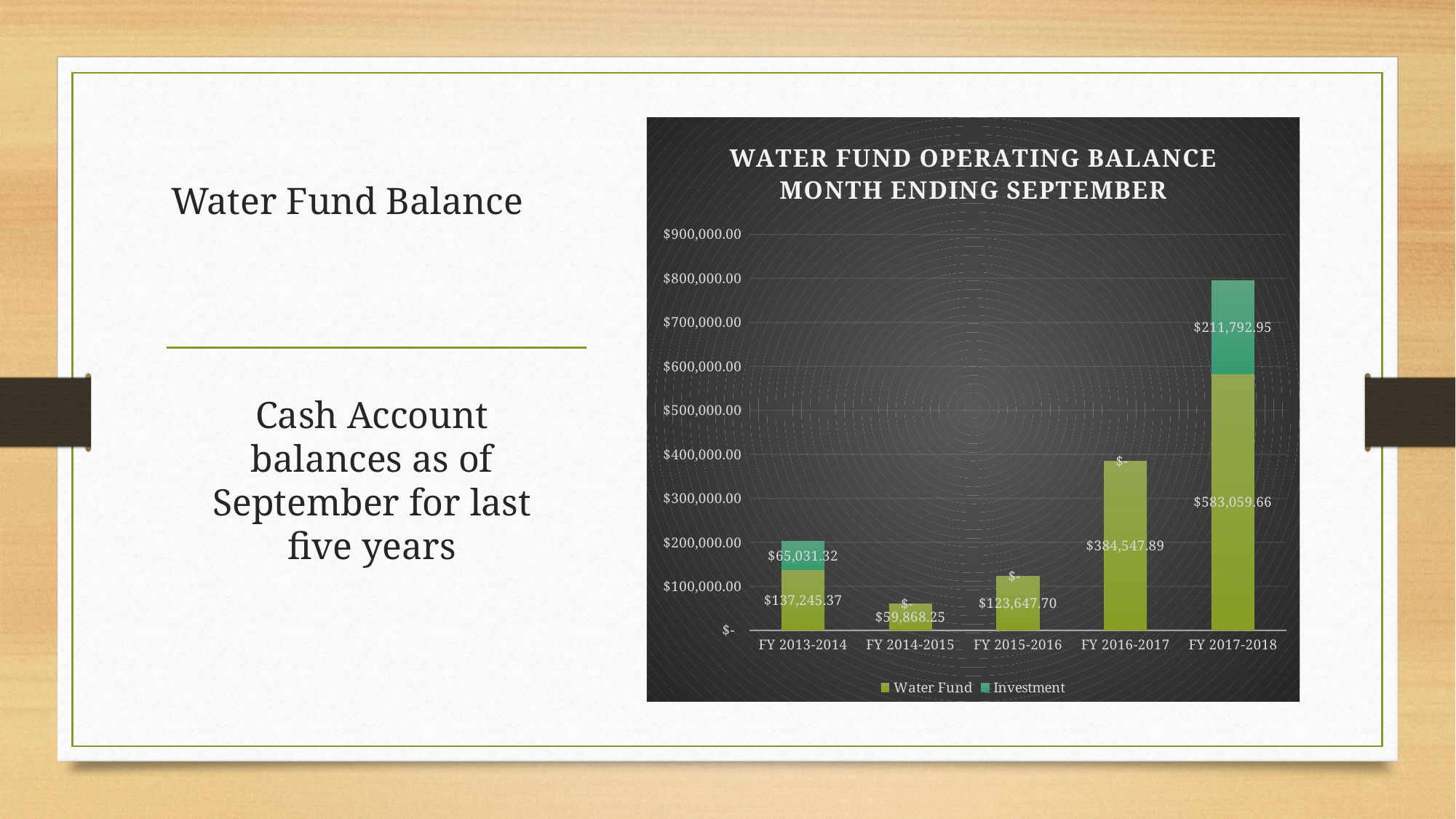
How many fiscal years are shown on the x axis? 5 Is the Water Fund value for FY 2015-2016 greater or less than $100,000.00? greater What is the Water Fund value for FY 2014-2015? $59,868.25 How many series does the legend list? 2 What is the title of the chart? WATER FUND OPERATING BALANCE MONTH ENDING SEPTEMBER Which fiscal year has the highest Water Fund value? FY 2017-2018 What is the total of the stacked bar for FY 2013-2014? $202,276.69 What type of chart is shown on the slide? stacked bar chart What is the difference between the Water Fund values for FY 2017-2018 and FY 2016-2017? $198,511.77 What is the Investment value for FY 2017-2018? $211,792.95 What is the Water Fund value for FY 2016-2017? $384,547.89 Which fiscal year has the lowest Water Fund value? FY 2014-2015